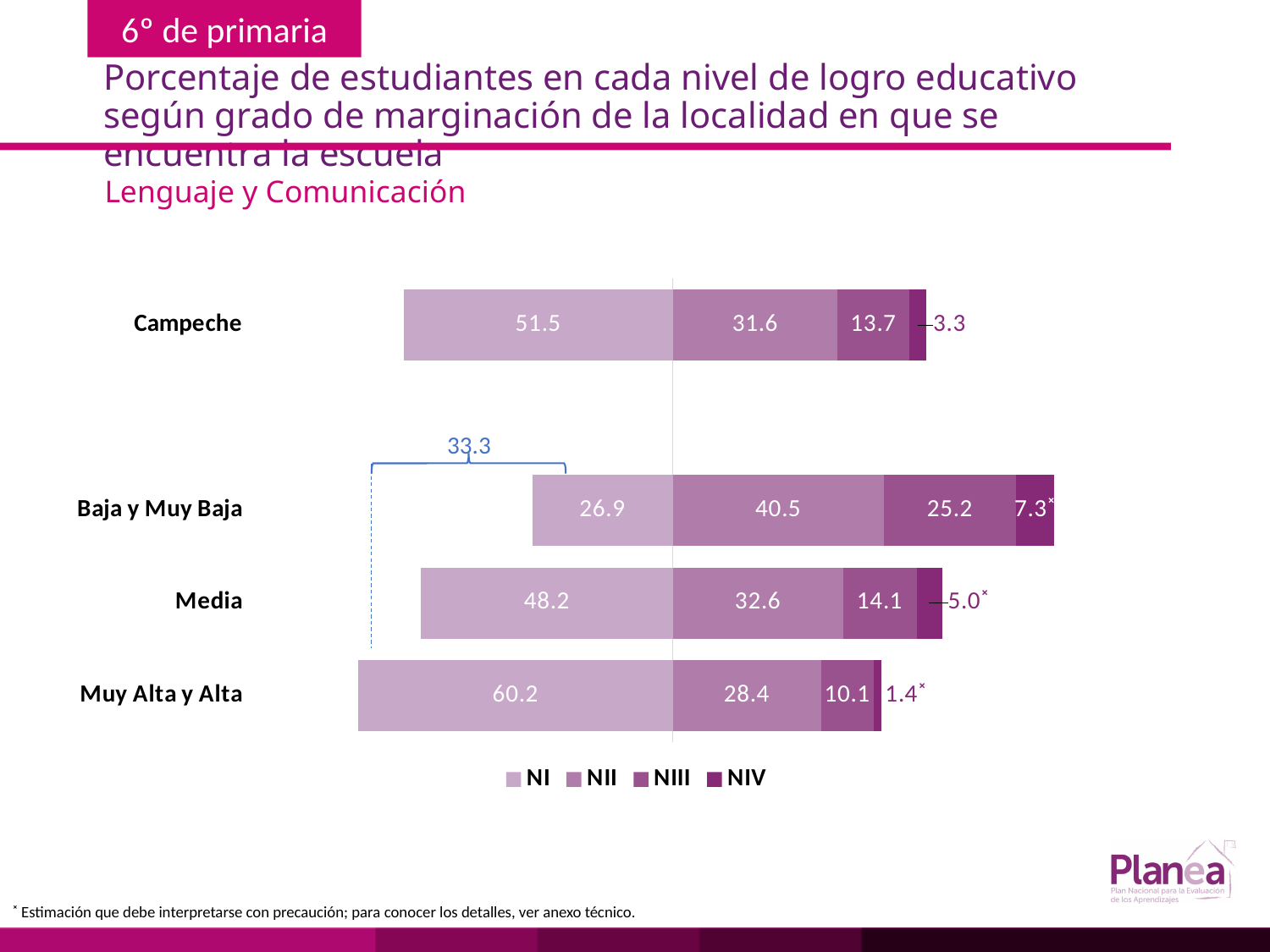
Which category has the lowest NIV value? Muy Alta y Alta What is the NIII value for Muy Alta y Alta? 10.1 How many categories are shown on the chart? 4 Which is larger, the NII value for Baja y Muy Baja or the NII value for Campeche? Baja y Muy Baja Which category has the highest NI value? Muy Alta y Alta What is the NII value for the Media category? 32.6 What kind of chart is shown on the slide? Stacked bar chart What is the NIV value for Baja y Muy Baja? 7.3 How many series does the legend list? 4 What percentage of students in Campeche are at level NI? 51.5 What is the difference between the NI values of Muy Alta y Alta and Baja y Muy Baja? 33.3 What is the difference between the NIII values of Baja y Muy Baja and Media? 11.1